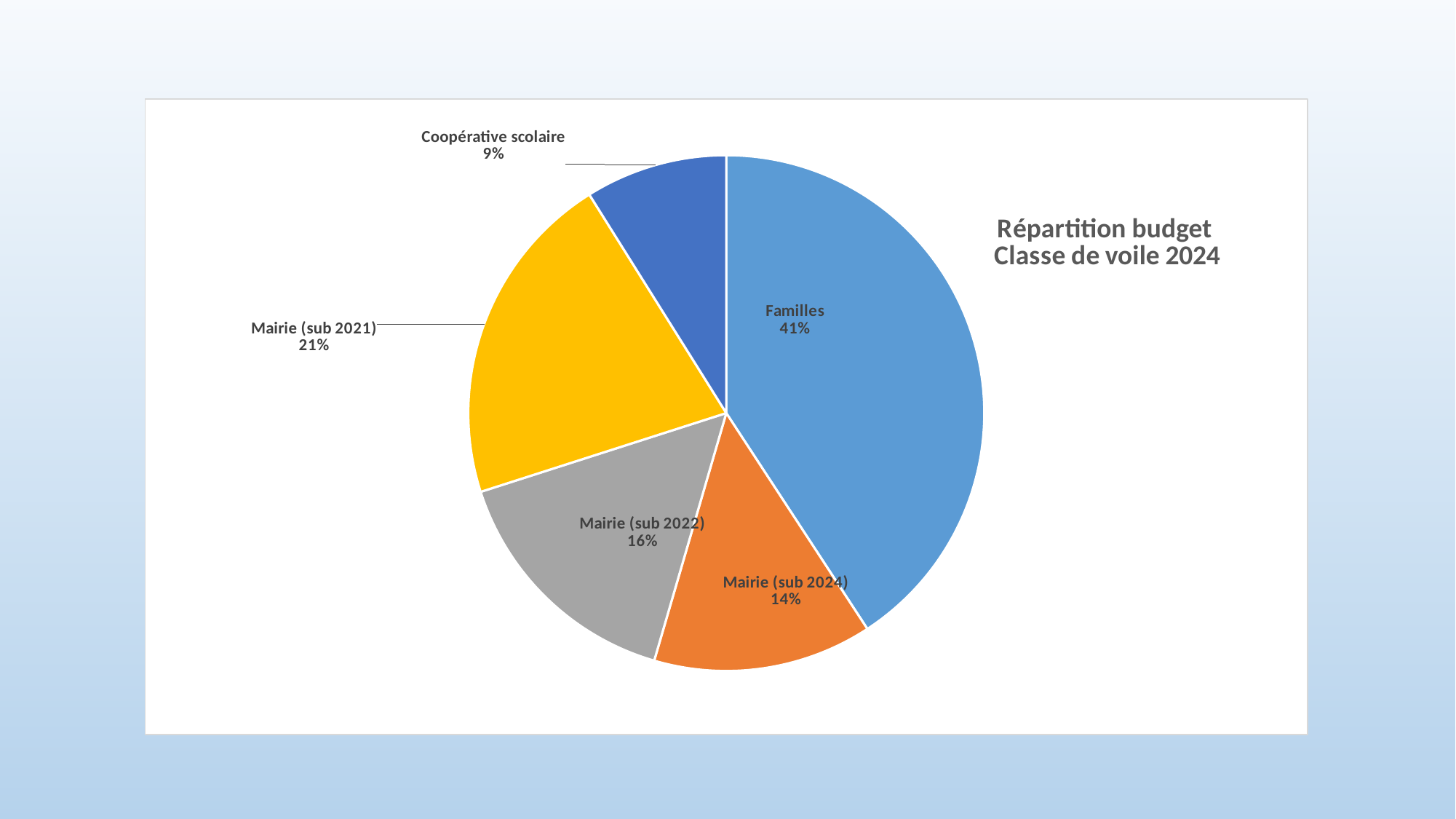
What share of the budget comes from Mairie (sub 2024)? 14% What share of the budget comes from Mairie (sub 2021)? 21% What share of the budget comes from Familles? 41% Which category has the largest share of the budget? Familles Which is larger, the share for Mairie (sub 2022) or Mairie (sub 2024)? Mairie (sub 2022) What is the difference in percentage points between Familles and Mairie (sub 2021)? 20 What kind of chart is shown on the slide? pie chart What is the title of the chart? Répartition budget Classe de voile 2024 What colour is the Familles slice? blue How many categories are shown in the pie chart? 5 Which category has the smallest share of the budget? Coopérative scolaire